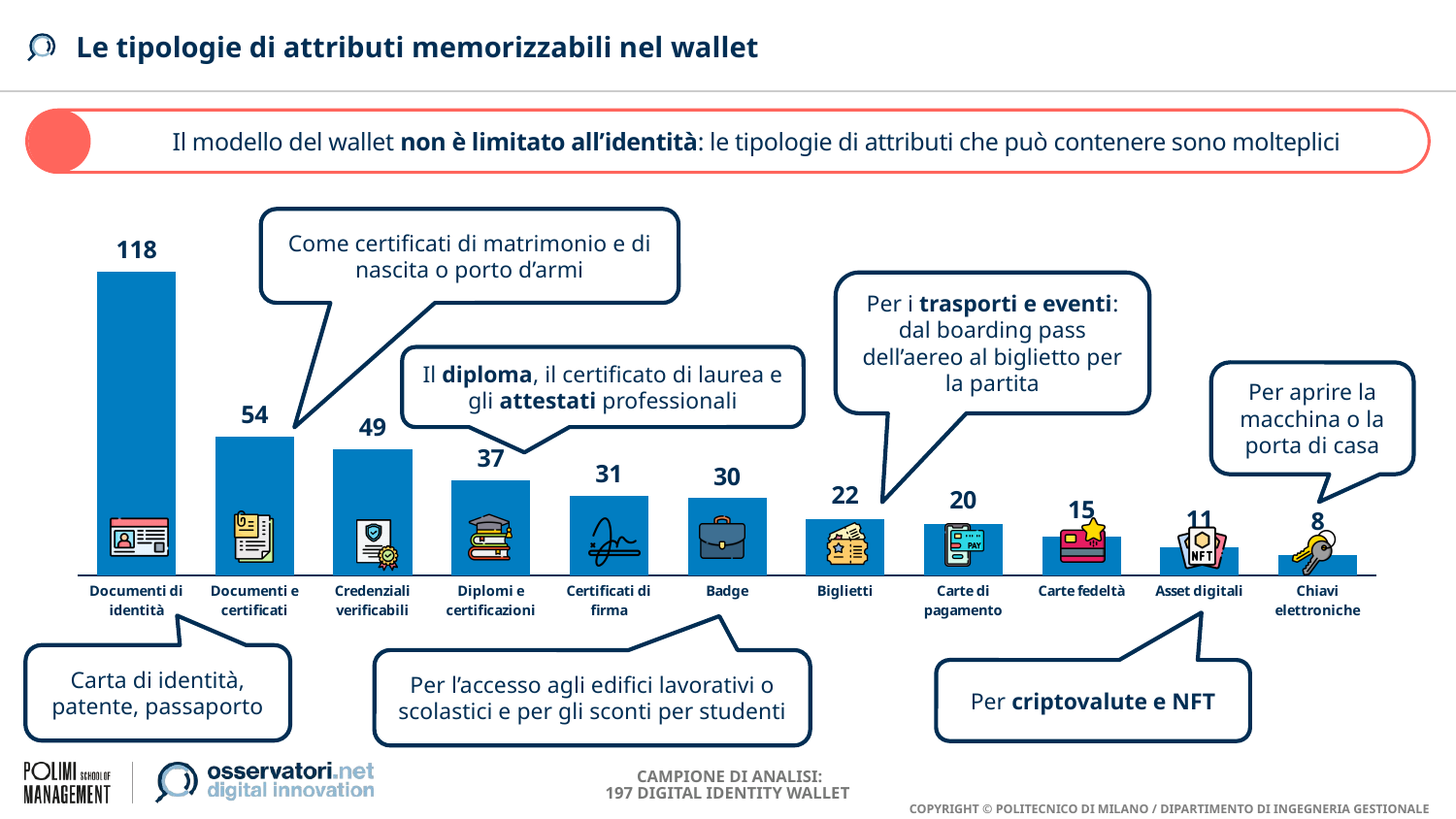
What is the difference between the values for Documenti di identità and Chiavi elettroniche? 110 What is the value for Asset digitali? 11 Which category has the lowest value? Chiavi elettroniche What is the value for Carte fedeltà? 15 What is the value for Documenti di identità? 118 Do the values rise or fall from left to right along the x axis? Fall What is the difference between the values for Documenti e certificati and Credenziali verificabili? 5 What kind of chart is shown on the slide? Bar chart Which is larger, the value for Diplomi e certificazioni or the value for Badge? Diplomi e certificazioni What is the value for Biglietti? 22 How many categories are shown in the chart? 11 Which category has the highest value? Documenti di identità